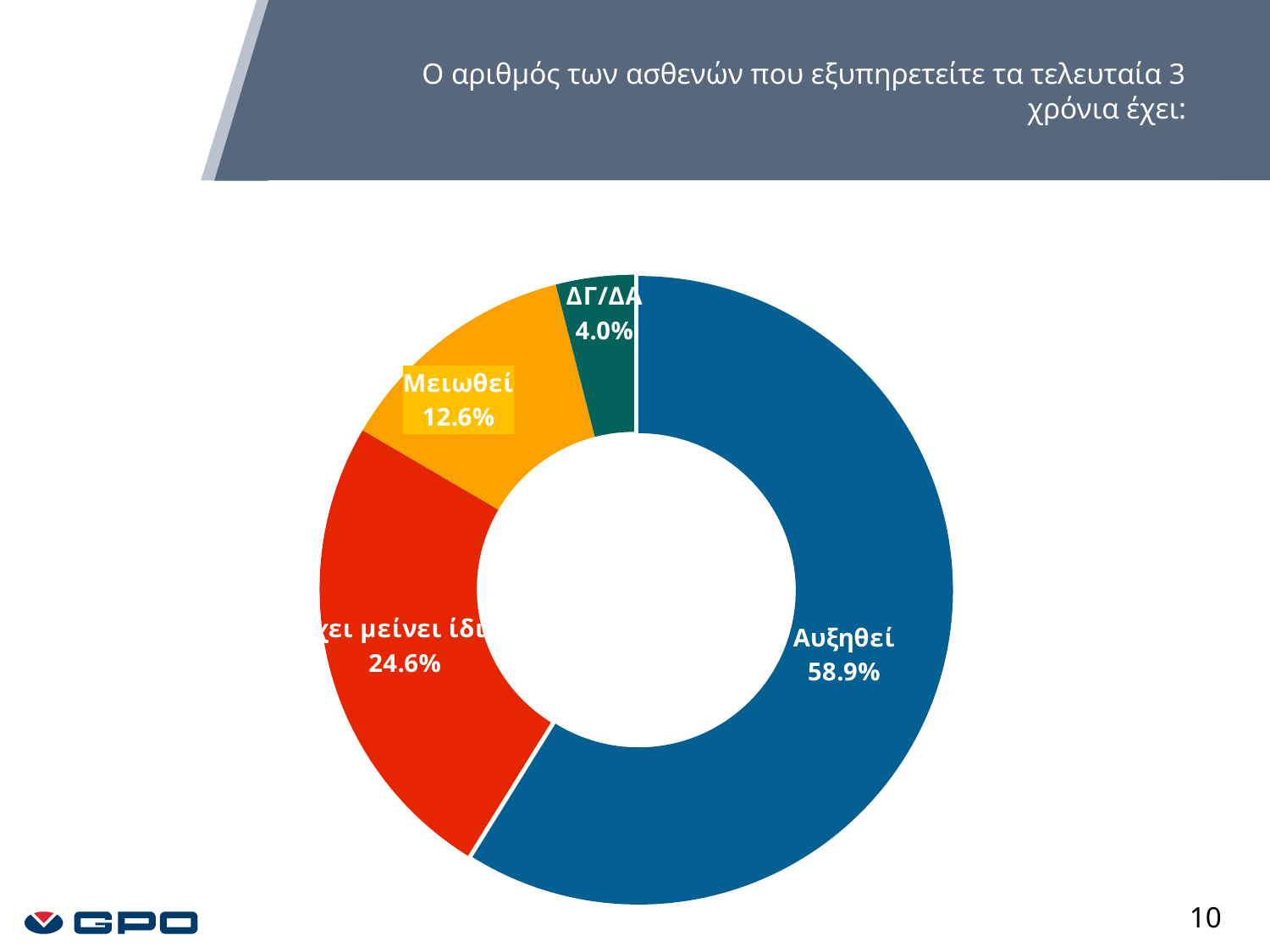
What percentage is shown for Μειωθεί? 12.6% What is the difference in percentage points between Αυξηθεί and Μειωθεί? 46.3 Which category has the largest share of the chart? Αυξηθεί What percentage is shown for Αυξηθεί? 58.9% Which is larger, the share for Μειωθεί or the share for ΔΓ/ΔΑ? Μειωθεί Which category has the smallest share of the chart? ΔΓ/ΔΑ What is the difference in percentage points between Μειωθεί and ΔΓ/ΔΑ? 8.6 What percentage is shown for the red slice of the chart? 24.6% How many slices does the chart have? 4 What percentage is shown for ΔΓ/ΔΑ? 4.0% What kind of chart is shown on the slide? Doughnut (pie) chart What colour is the slice for Αυξηθεί? Blue